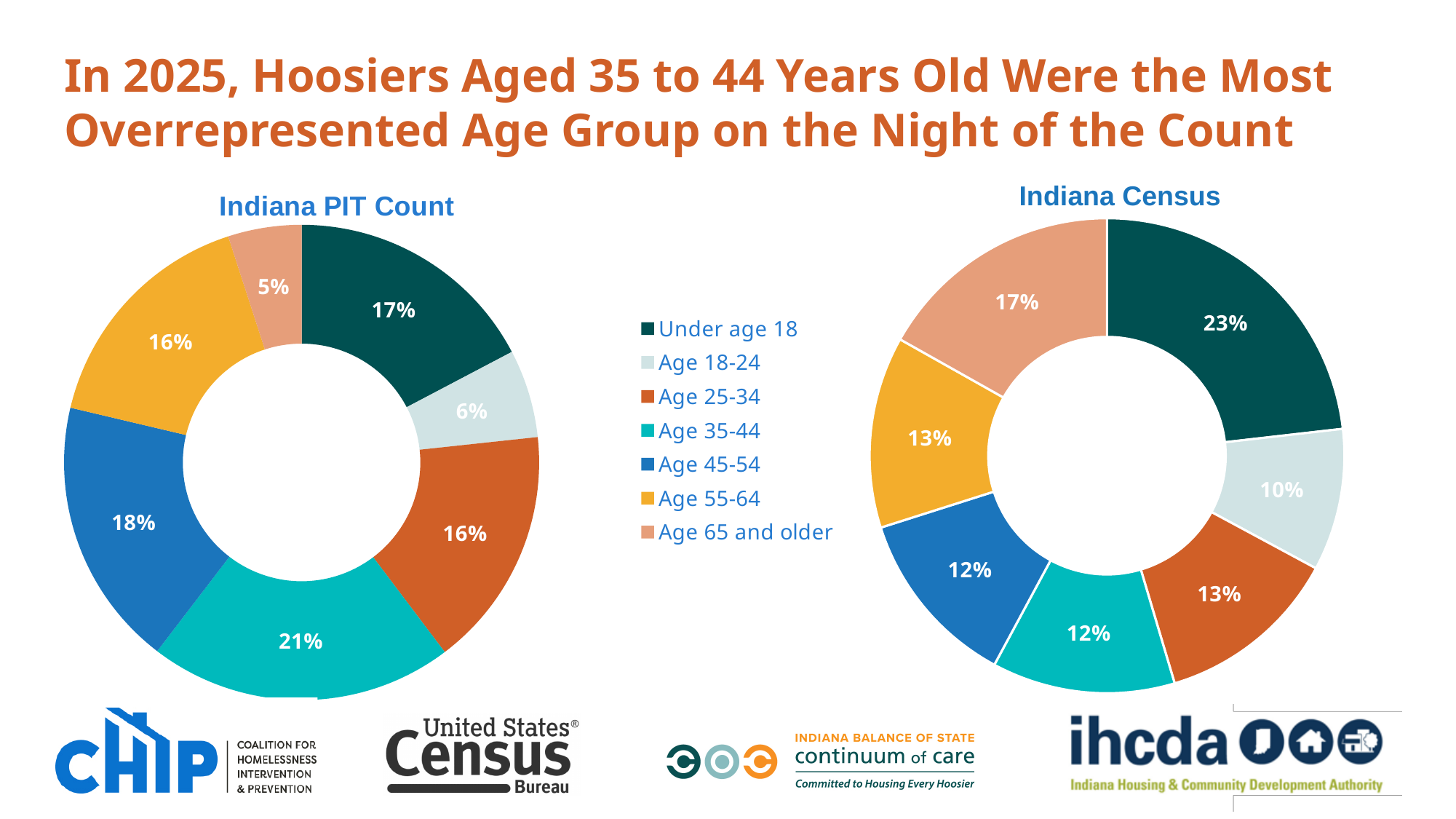
In the Indiana Census chart, what share is Age 65 and older? 17% In the Indiana PIT Count chart, which age group has the smallest share? Age 65 and older In the Indiana PIT Count chart, what share is Age 35-44? 21% In the Indiana PIT Count chart, which age group has the largest share? Age 35-44 What is the difference between the Age 35-44 share in the Indiana PIT Count chart and in the Indiana Census chart? 9 percentage points In the Indiana Census chart, what share is Under age 18? 23% In the Indiana PIT Count chart, what share is Age 65 and older? 5% What kind of charts are shown on the slide? Pie (donut) charts How many age groups does the legend list? 7 In the Indiana Census chart, which age group has the smallest share? Age 18-24 In the Indiana PIT Count chart, which is larger: the share for Age 45-54 or the share for Age 55-64? Age 45-54 In the Indiana Census chart, which age group has the largest share? Under age 18